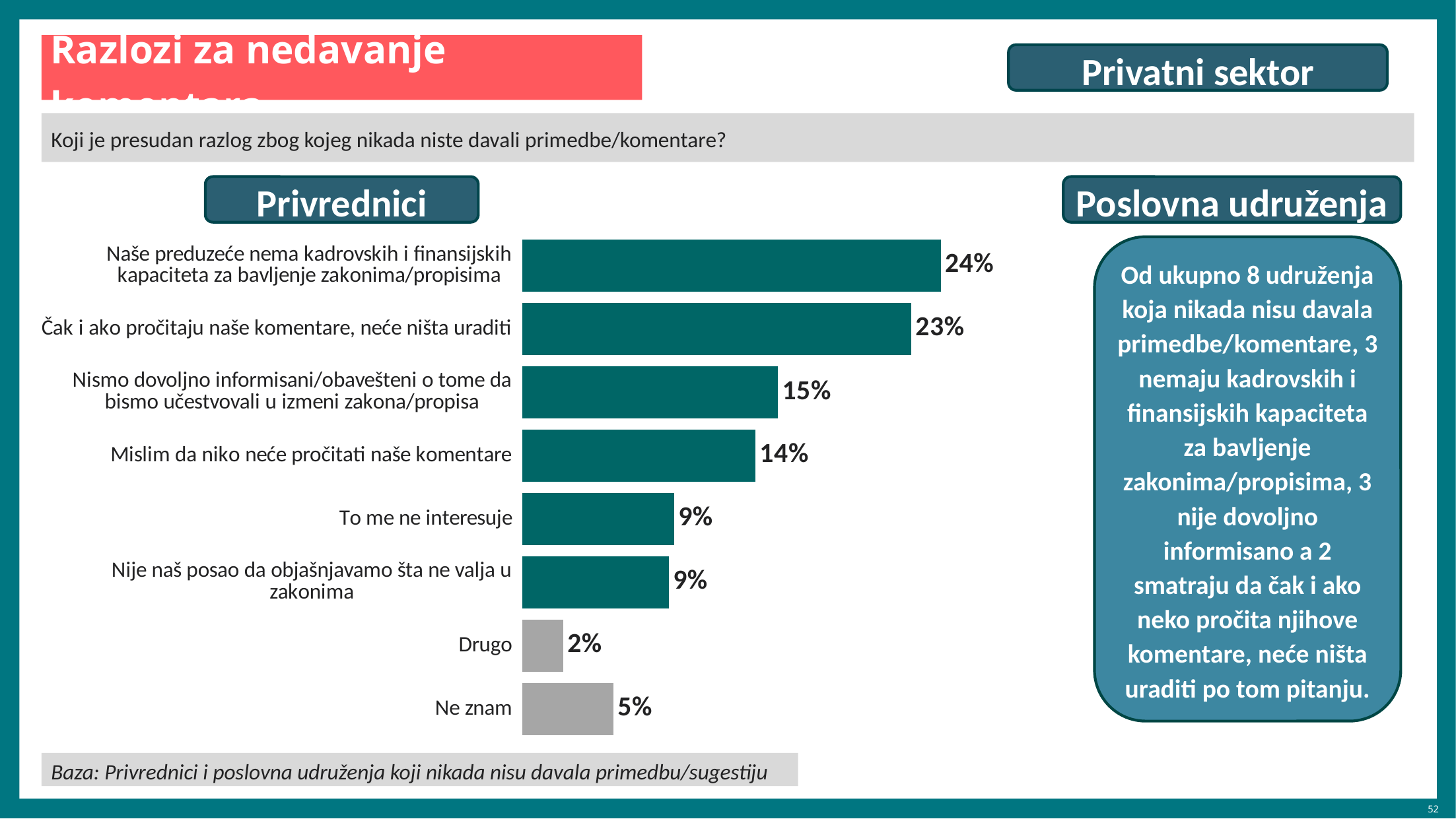
What is the difference between the values for "Ne znam" and "Drugo"? 3% What kind of chart is shown on the slide? Bar chart Which two categories are shown with grey bars instead of teal bars? Drugo and Ne znam How many categories are shown in the chart? 8 Which is larger: the value for "Mislim da niko neće pročitati naše komentare" or the value for "To me ne interesuje"? Mislim da niko neće pročitati naše komentare Which category has the highest value in the chart? Naše preduzeće nema kadrovskih i finansijskih kapaciteta za bavljenje zakonima/propisima What percentage is shown for "Ne znam"? 5% Which category has the lowest value in the chart? Drugo What value is shown for "Čak i ako pročitaju naše komentare, neće ništa uraditi"? 23% What value is shown for "Mislim da niko neće pročitati naše komentare"? 14% What is the difference between the values for "Naše preduzeće nema kadrovskih i finansijskih kapaciteta za bavljenje zakonima/propisima" and "Nismo dovoljno informisani/obavešteni o tome da bismo učestvovali u izmeni zakona/propisa"? 9% What percentage is shown for "To me ne interesuje"? 9%